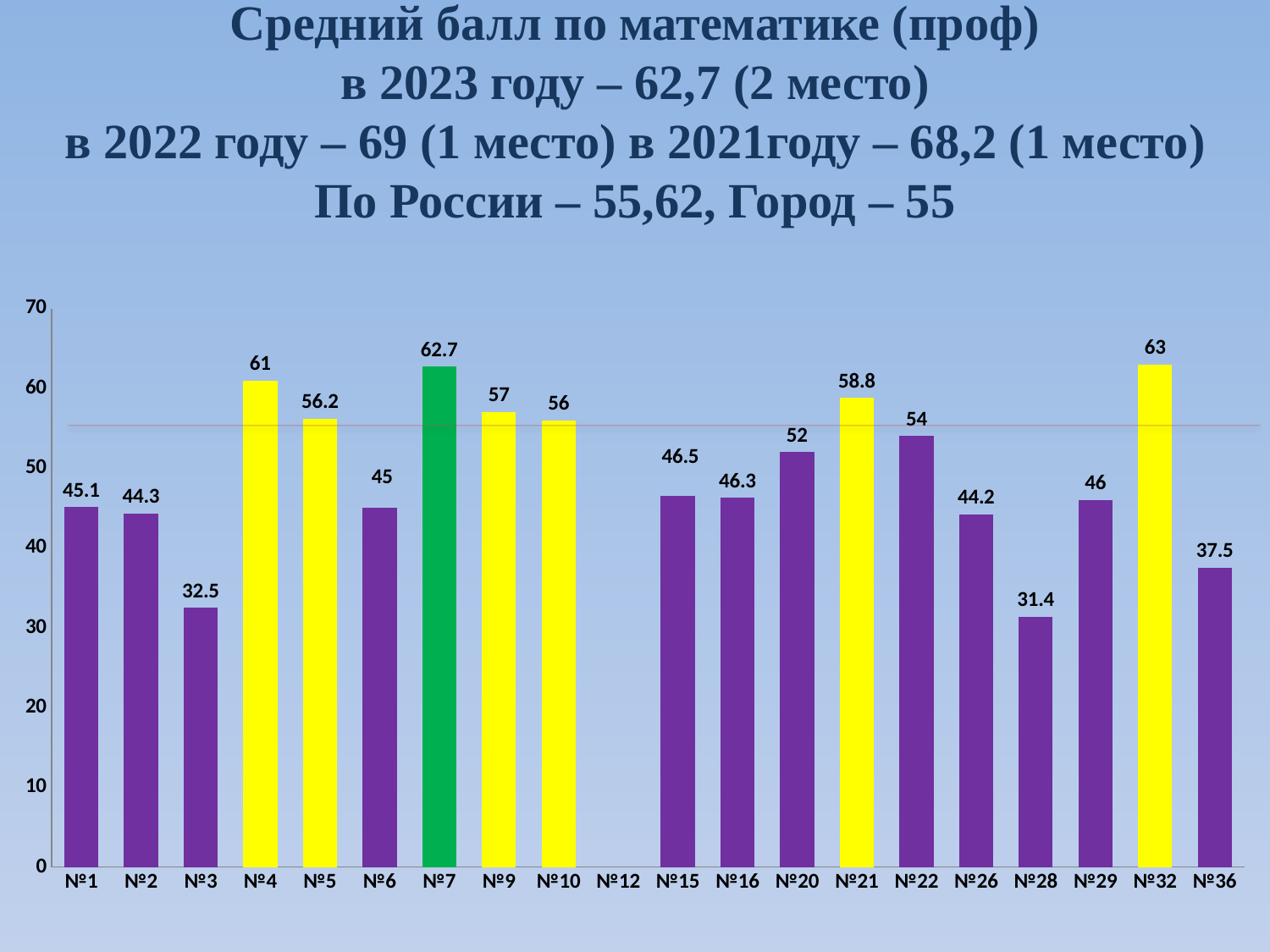
Which category on the x axis has no bar plotted? №12 What is the difference between the values for №32 and №7? 0.3 What is the value shown for №7? 62.7 What kind of chart is shown on the slide? bar chart What is the difference between the values for №4 and №3? 28.5 How many category labels are shown on the x axis? 20 Which category has the lowest value? №28 What is the value shown for №28? 31.4 What is the value shown for №21? 58.8 Is the value for №20 greater or less than 50? greater Which category has the highest value? №32 Which is larger, the value for №9 or the value for №10? №9